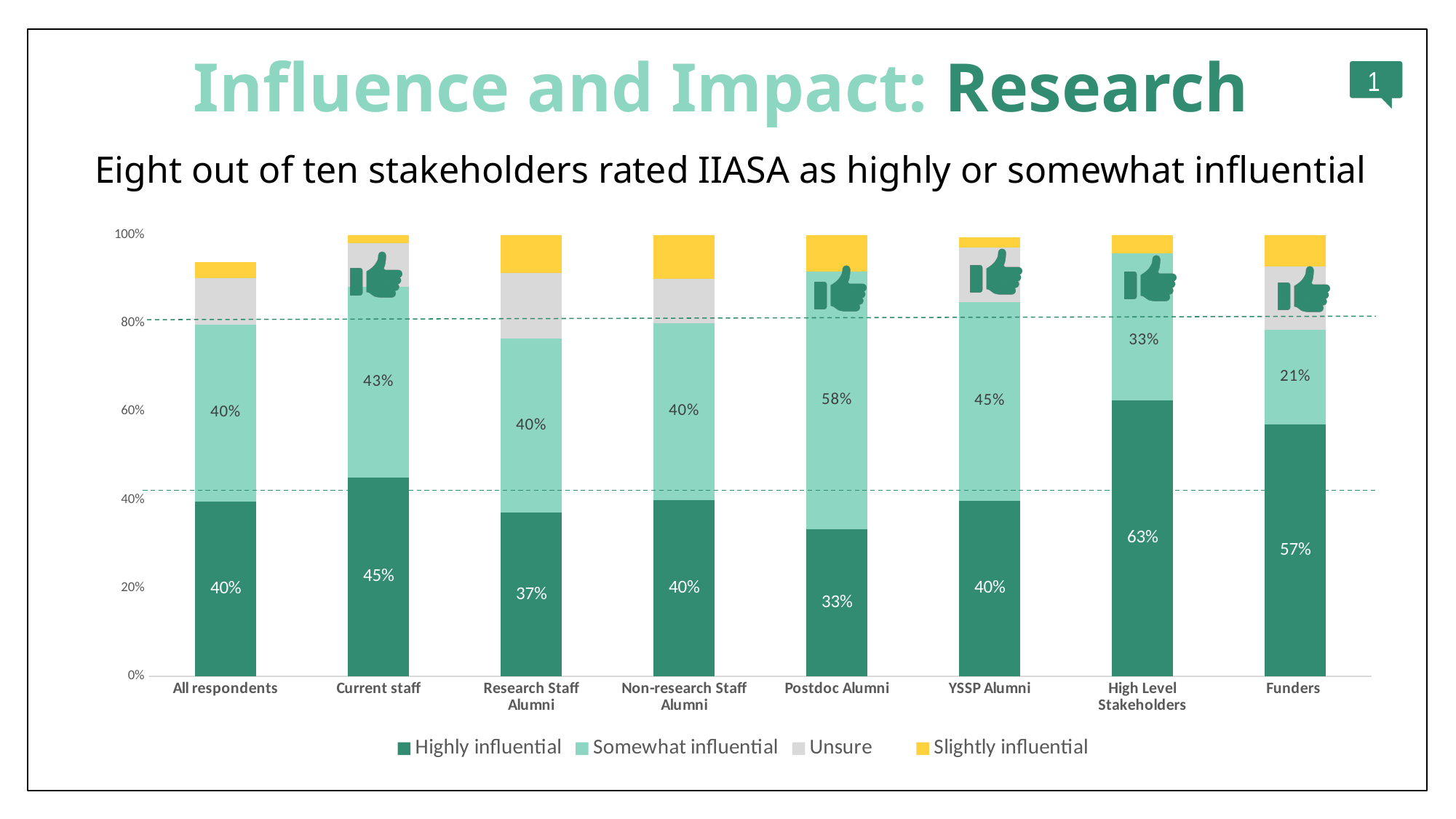
What is the combined 'Highly influential' and 'Somewhat influential' percentage for Postdoc Alumni? 91% How many respondent groups are shown on the x axis? 8 Which group has a larger 'Highly influential' share: Current staff or Research Staff Alumni? Current staff Which respondent group has the lowest 'Somewhat influential' percentage? Funders How many percentage points higher is the 'Highly influential' value for High Level Stakeholders than for Funders? 6 percentage points What percentage of Postdoc Alumni rated IIASA as somewhat influential? 58% What is the 'Somewhat influential' value for Funders? 21% Which respondent group has the highest 'Highly influential' percentage? High Level Stakeholders How many series does the legend list? 4 Which respondent group has the lowest 'Highly influential' percentage? Postdoc Alumni What type of chart is shown on the slide? Stacked bar chart What percentage of High Level Stakeholders rated IIASA as highly influential? 63%